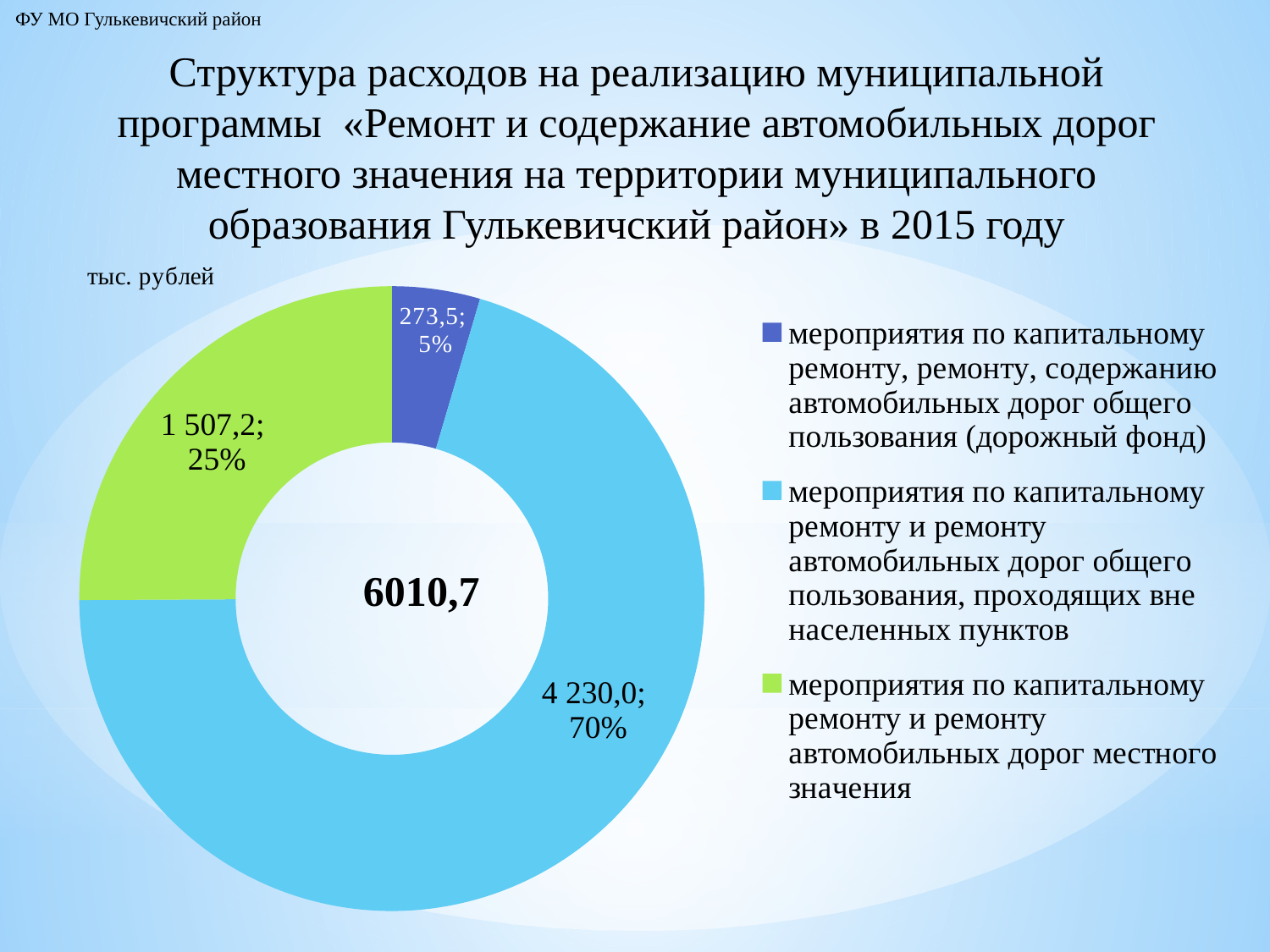
Какую долю расходов составляют мероприятия по капитальному ремонту и ремонту автомобильных дорог местного значения? 25% Какую долю расходов составляют мероприятия по дорожному фонду (капитальный ремонт, ремонт, содержание дорог общего пользования)? 5% Какое значение (тыс. рублей) приходится на мероприятия по капитальному ремонту и ремонту автомобильных дорог общего пользования, проходящих вне населенных пунктов? 4 230,0 Какое значение (тыс. рублей) приходится на мероприятия по капитальному ремонту и ремонту автомобильных дорог местного значения? 1 507,2 Сколько категорий (секторов) показано на диаграмме? 3 Какова общая сумма расходов, указанная в центре диаграммы? 6010,7 Сколько элементов перечислено в легенде диаграммы? 3 На сколько тыс. рублей расходы на дороги вне населенных пунктов (4 230,0) превышают расходы на дороги местного значения (1 507,2)? 2 722,8 Какое значение (тыс. рублей) приходится на мероприятия по капитальному ремонту, ремонту, содержанию автомобильных дорог общего пользования (дорожный фонд)? 273,5 Какой тип диаграммы показан на слайде? кольцевая (круговая) диаграмма Какая категория расходов имеет наибольшее значение? мероприятия по капитальному ремонту и ремонту автомобильных дорог общего пользования, проходящих вне населенных пунктов Какая категория расходов имеет наименьшее значение? мероприятия по капитальному ремонту, ремонту, содержанию автомобильных дорог общего пользования (дорожный фонд)